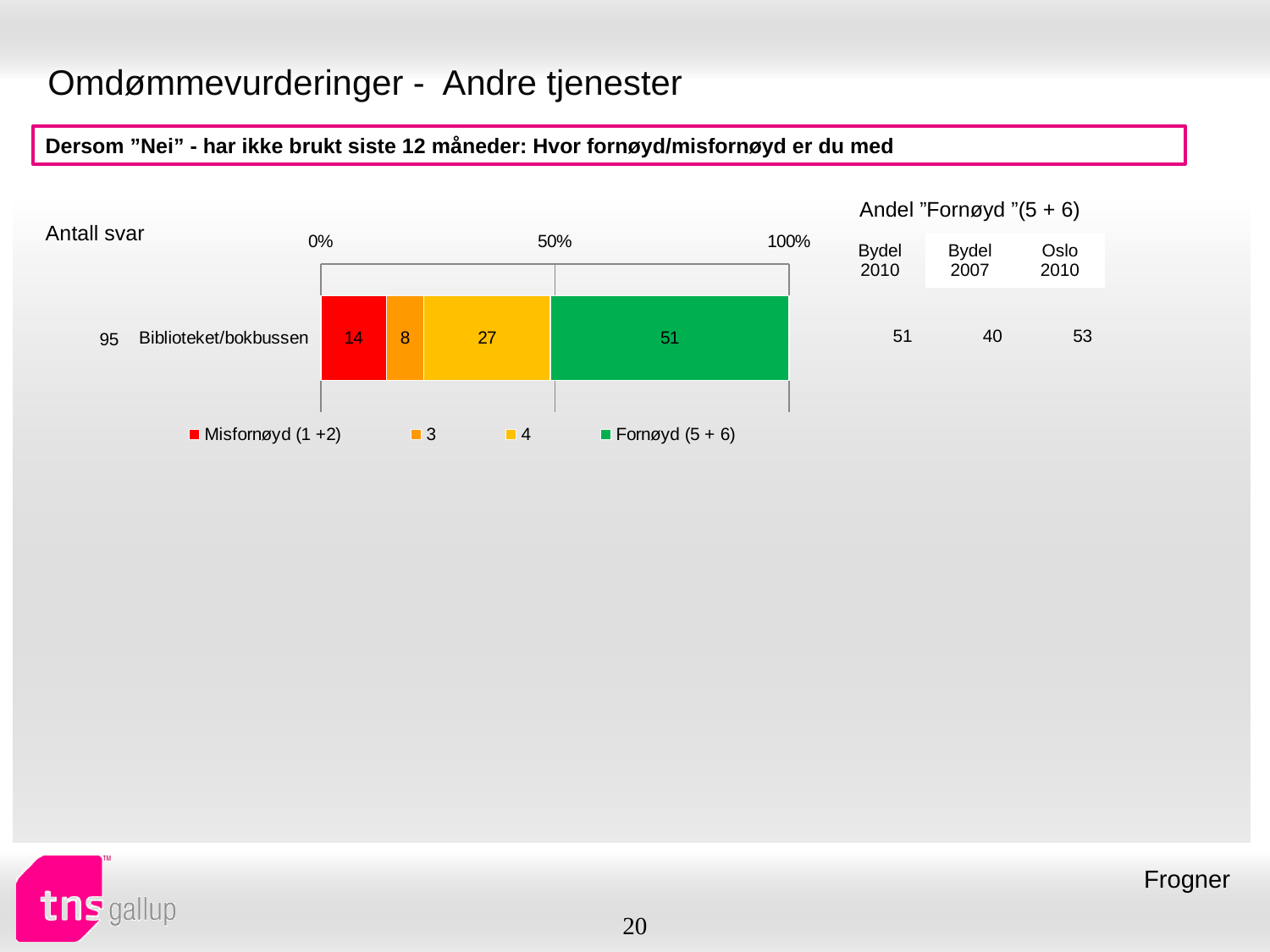
Which series has the smallest segment in the Biblioteket/bokbussen bar? 3 What is the difference between the Fornøyd (5 + 6) segment and the Misfornøyd (1 +2) segment for Biblioteket/bokbussen? 37 How many categories are plotted in the chart? 1 What kind of chart is shown on the slide? Stacked bar chart What is the value of the Misfornøyd (1 +2) segment for Biblioteket/bokbussen? 14 What is the value of the segment labelled 3 for Biblioteket/bokbussen? 8 How many series does the legend list? 4 What is the value of the Fornøyd (5 + 6) segment for Biblioteket/bokbussen? 51 Which is larger for Biblioteket/bokbussen, the segment labelled 4 or the Misfornøyd (1 +2) segment? 4 What is the value of the segment labelled 4 for Biblioteket/bokbussen? 27 What is the total of all segments in the Biblioteket/bokbussen bar? 100 Which series has the largest segment in the Biblioteket/bokbussen bar? Fornøyd (5 + 6)